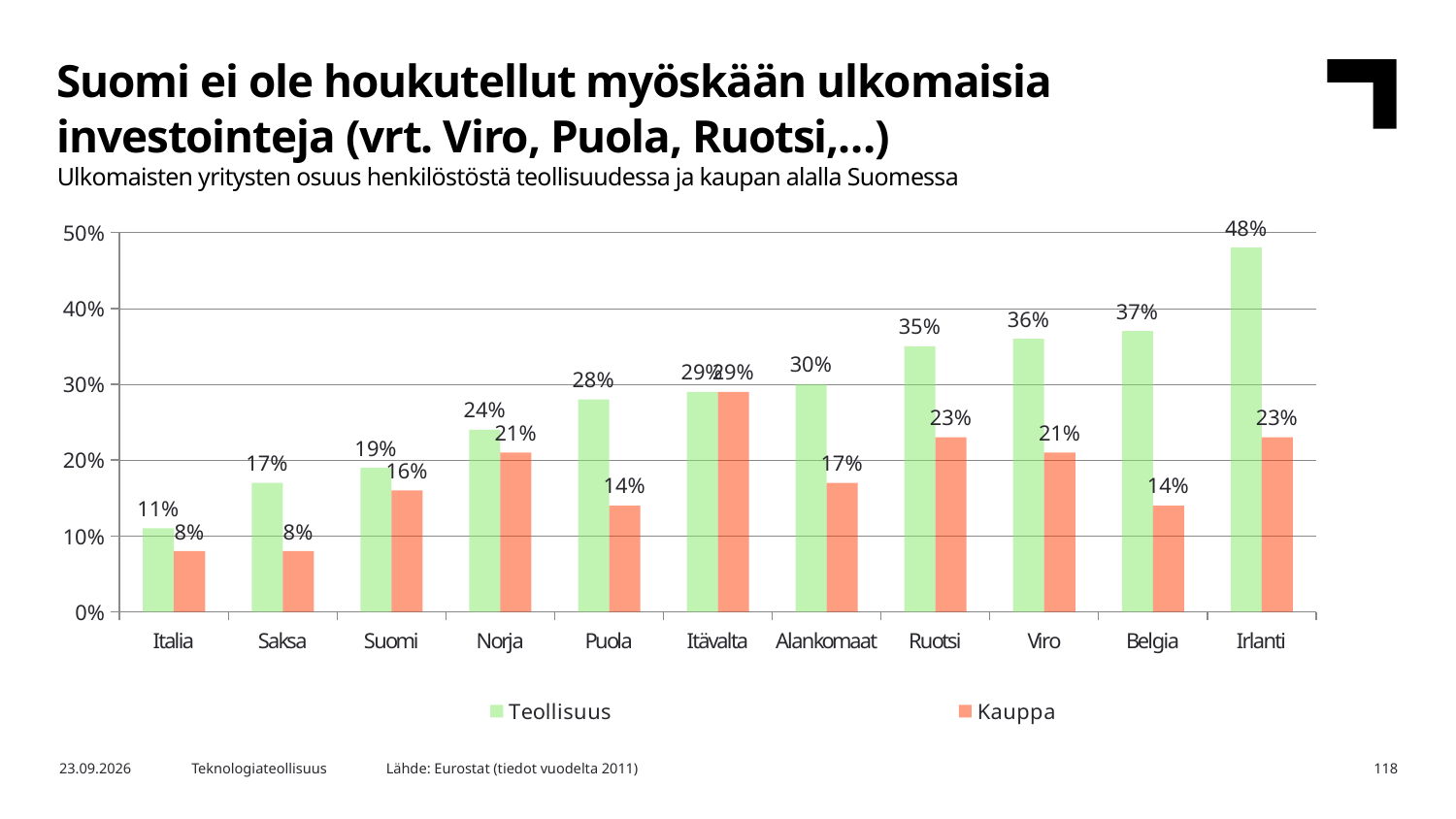
Which country has the lowest Teollisuus value? Italia How many countries are shown on the x axis? 11 How many series does the legend list? 2 Which is larger, the Kauppa value for Norja or the Kauppa value for Puola? Norja Which series is shown in green in the legend? Teollisuus What is the difference between the Teollisuus values for Irlanti and Suomi? 29% Do the Teollisuus values rise or fall from Italia to Irlanti along the x axis? Rise What kind of chart is shown on the slide? Bar chart Which country has the highest Teollisuus value? Irlanti What is the Kauppa value for Ruotsi? 23% What is the Teollisuus value for Suomi? 19% What is the Kauppa value for Itävalta? 29%